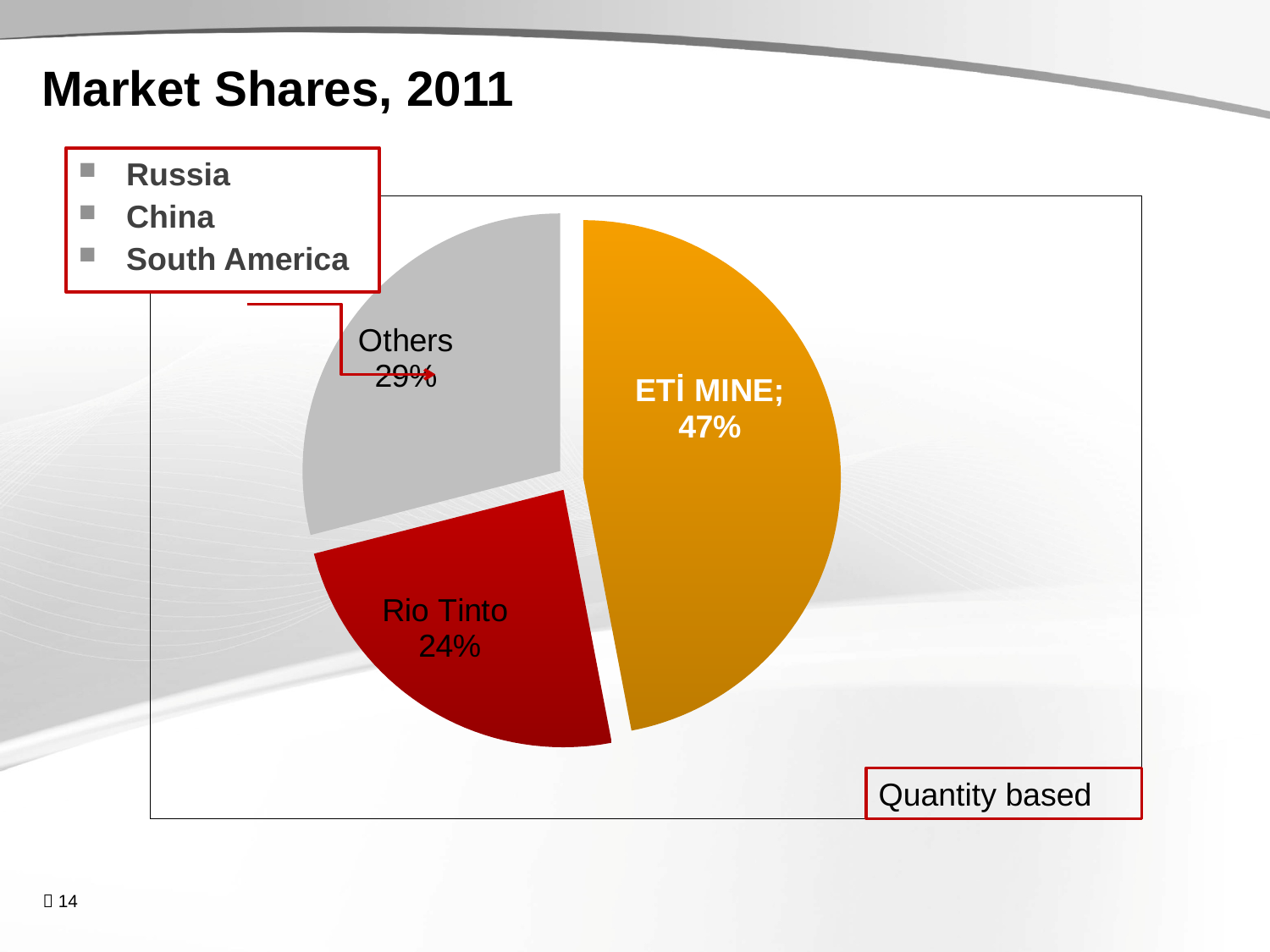
Which slice of the pie chart is the largest? ETİ MINE Which regions are listed in the callout box pointing to the Others slice? Russia, China, South America What share of the market does Rio Tinto hold in the pie chart? 24% Which slice of the pie chart is the smallest? Rio Tinto How many slices does the pie chart have? 3 What is the title of the slide containing the chart? Market Shares, 2011 What share of the market does ETİ MINE hold in the pie chart? 47% What is the difference in percentage points between the ETİ MINE share and the Rio Tinto share? 23 What kind of chart is shown on the slide? Pie chart Which is larger, the Others share or the Rio Tinto share? Others What share of the market is labelled Others in the pie chart? 29% What is the difference in percentage points between the Others share and the Rio Tinto share? 5